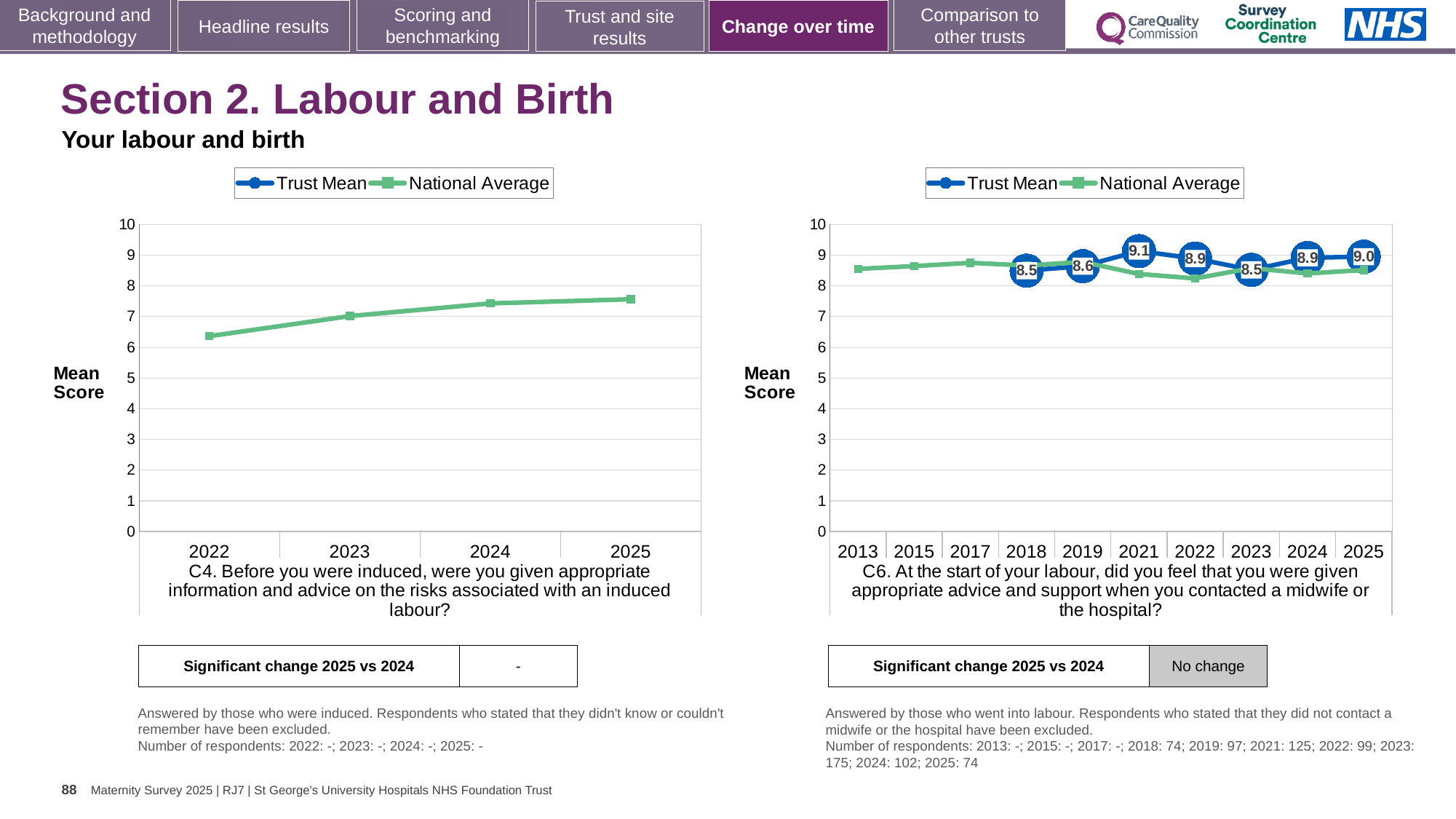
In the right chart (C6), what is the Trust Mean for 2021? 9.1 In the left chart (C4), is the National Average for 2022 greater or less than 7? less In the left chart (C4), is the National Average for 2025 greater or less than 7? greater In the left chart (C4), how many years are shown on the x axis? 4 In the right chart (C6), what is the Trust Mean for 2025? 9.0 In the right chart (C6), which year has the larger Trust Mean, 2022 or 2023? 2022 In the left chart (C4), does the National Average rise or fall from 2022 to 2025? rise In the right chart (C6), how many years are shown on the x axis? 10 In the right chart (C6), what is the difference between the Trust Mean in 2021 and in 2018? 0.6 In the left chart (C4), what kind of chart is shown? line chart In the right chart (C6), which year has the highest Trust Mean? 2021 In the left chart (C4), how many series does the legend list? 2